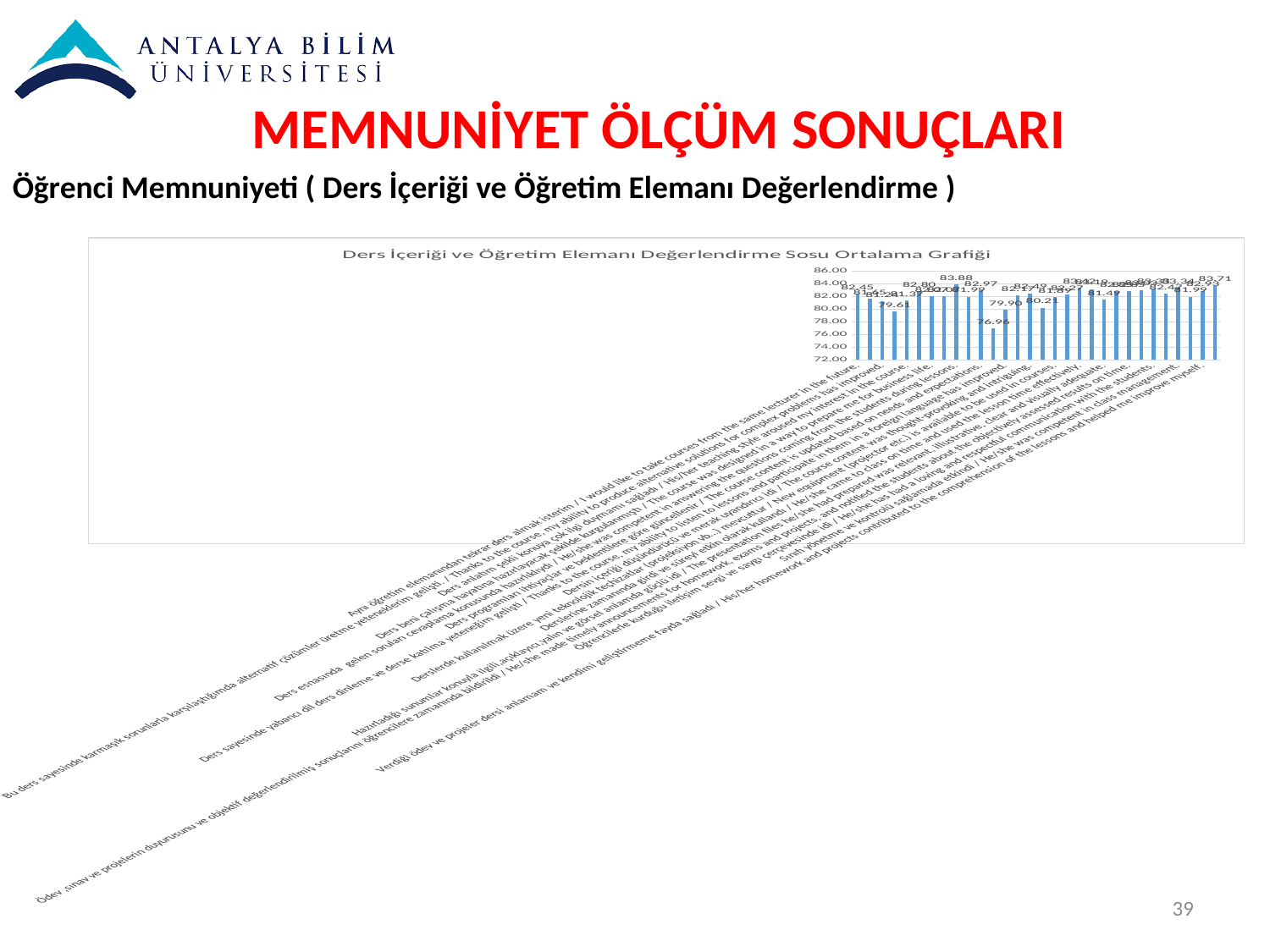
Is the lowest bar in the chart greater or less than 78.00? less What is the lowest value marked on the vertical axis of the chart? 72.00 Is the tallest bar in the chart greater or less than 84.00? less What is the lowest value shown by any bar in the chart? 76.96 What kind of chart is shown on the slide? bar chart Is the lowest bar in the chart greater or less than 74.00? greater What is the title of the chart? Ders İçeriği ve Öğretim Elemanı Değerlendirme Sosu Ortalama Grafiği